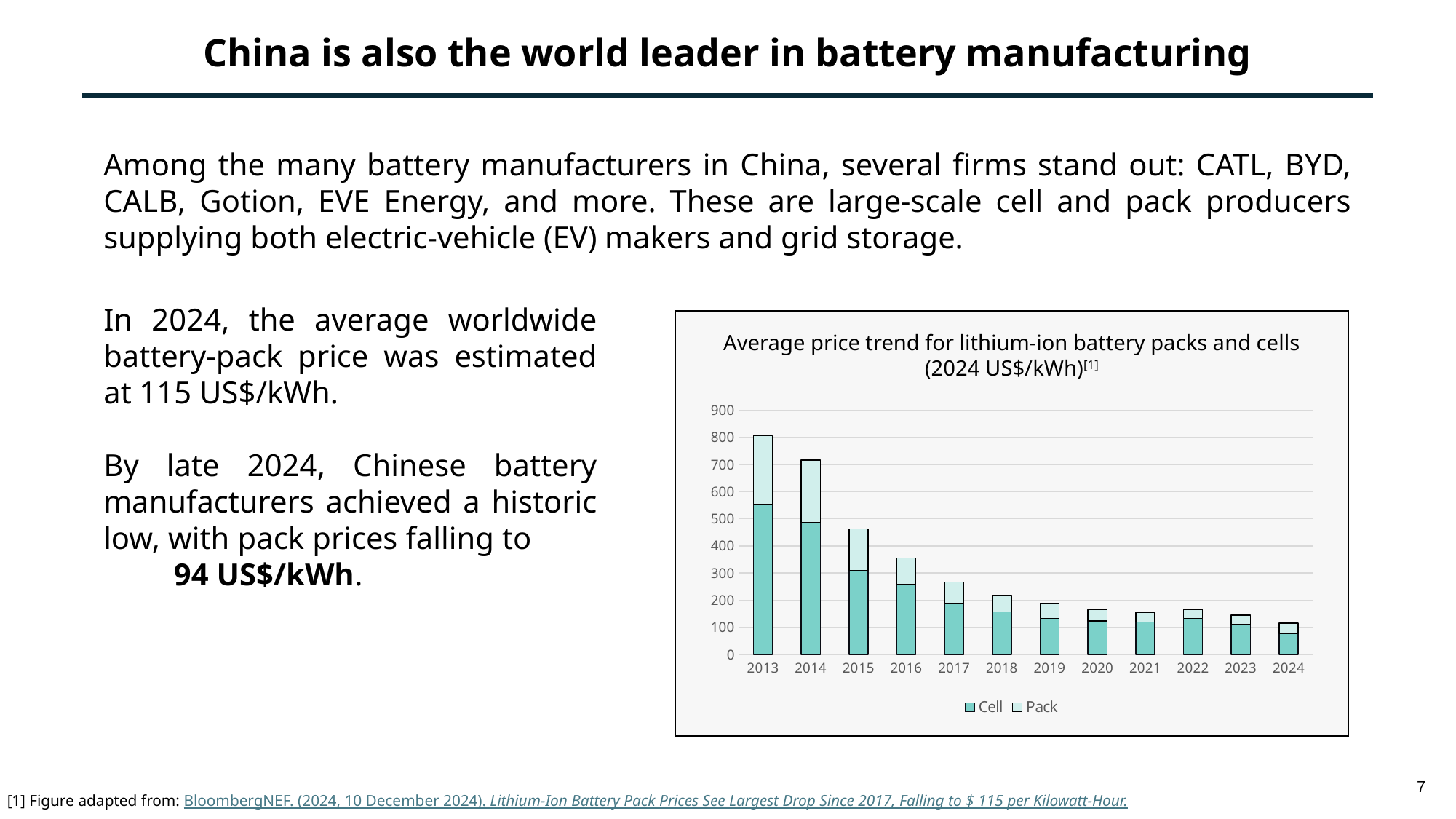
Is the Cell value for 2013 greater or less than 500? greater Which year has the highest total bar in the chart? 2013 Which is larger, the total bar for 2014 or the total bar for 2016? 2014 How many years are shown on the x axis of the chart? 12 Do the total bar heights rise or fall from 2013 to 2024? Fall Is the Cell value for 2024 greater or less than 100? less What kind of chart is shown on the slide? Stacked bar chart What are the two series named in the chart's legend? Cell and Pack Is the total bar for 2015 greater or less than 500? less How many series does the chart's legend list? 2 Which year has the lowest total bar in the chart? 2024